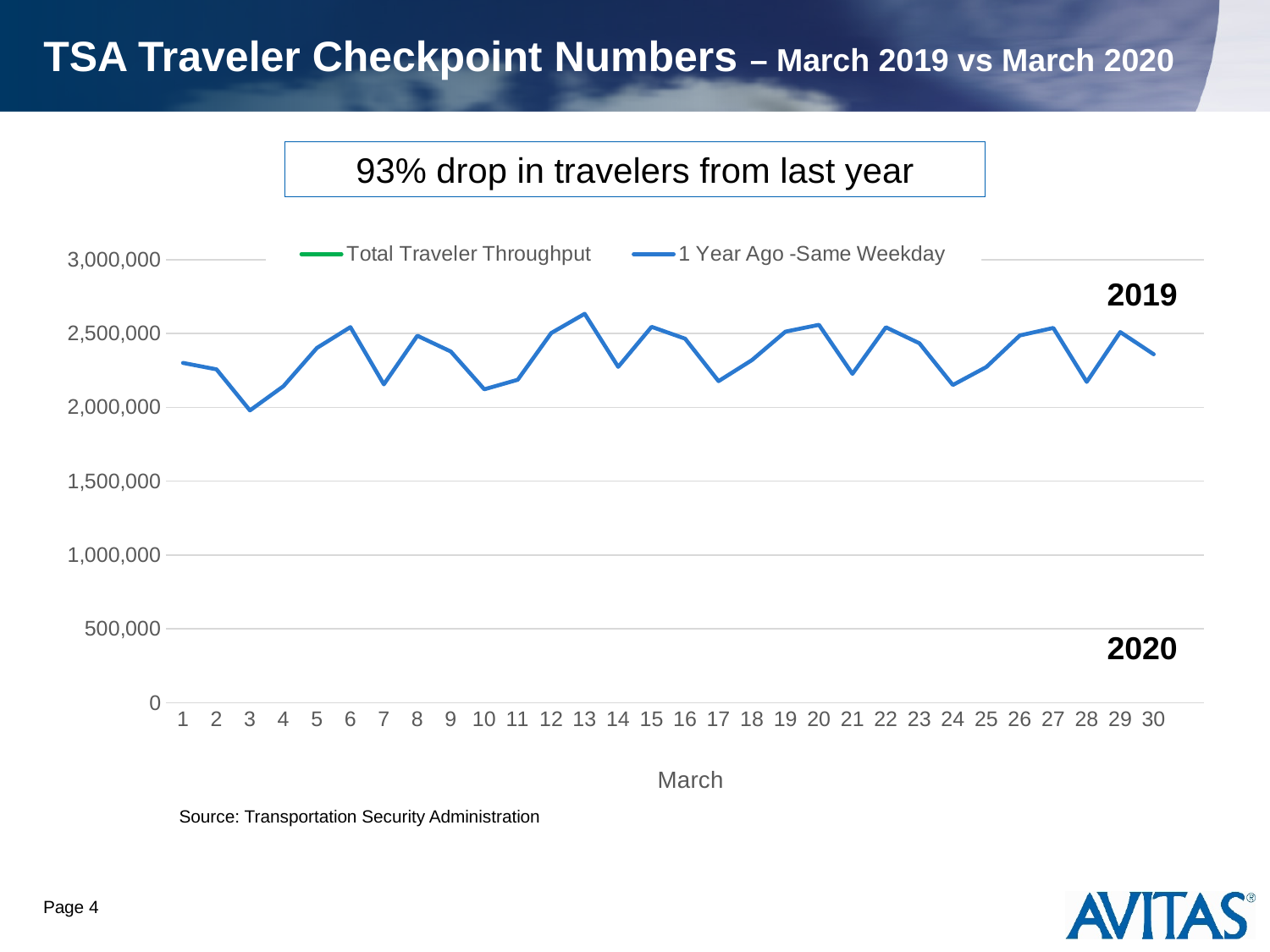
On which day of March does the '1 Year Ago - Same Weekday' line reach its lowest value? 3 Does the '1 Year Ago - Same Weekday' line rise or fall from March 3 to March 6? rise Is the value of the '1 Year Ago - Same Weekday' line on March 10 greater or less than 2,500,000? less What is the title of the x axis of the chart? March Is the value of the '1 Year Ago - Same Weekday' line on March 13 greater or less than 2,500,000? greater On which day of March does the '1 Year Ago - Same Weekday' line reach its highest value? 13 Is the value of the '1 Year Ago - Same Weekday' line on March 1 greater or less than 2,000,000? greater For the '1 Year Ago - Same Weekday' line, which day has the larger value, March 7 or March 13? March 13 What colour is the '1 Year Ago - Same Weekday' series in the legend? blue How many series does the chart legend list? 2 How many days of March are shown along the x axis of the chart? 30 What kind of chart is shown on the slide? line chart